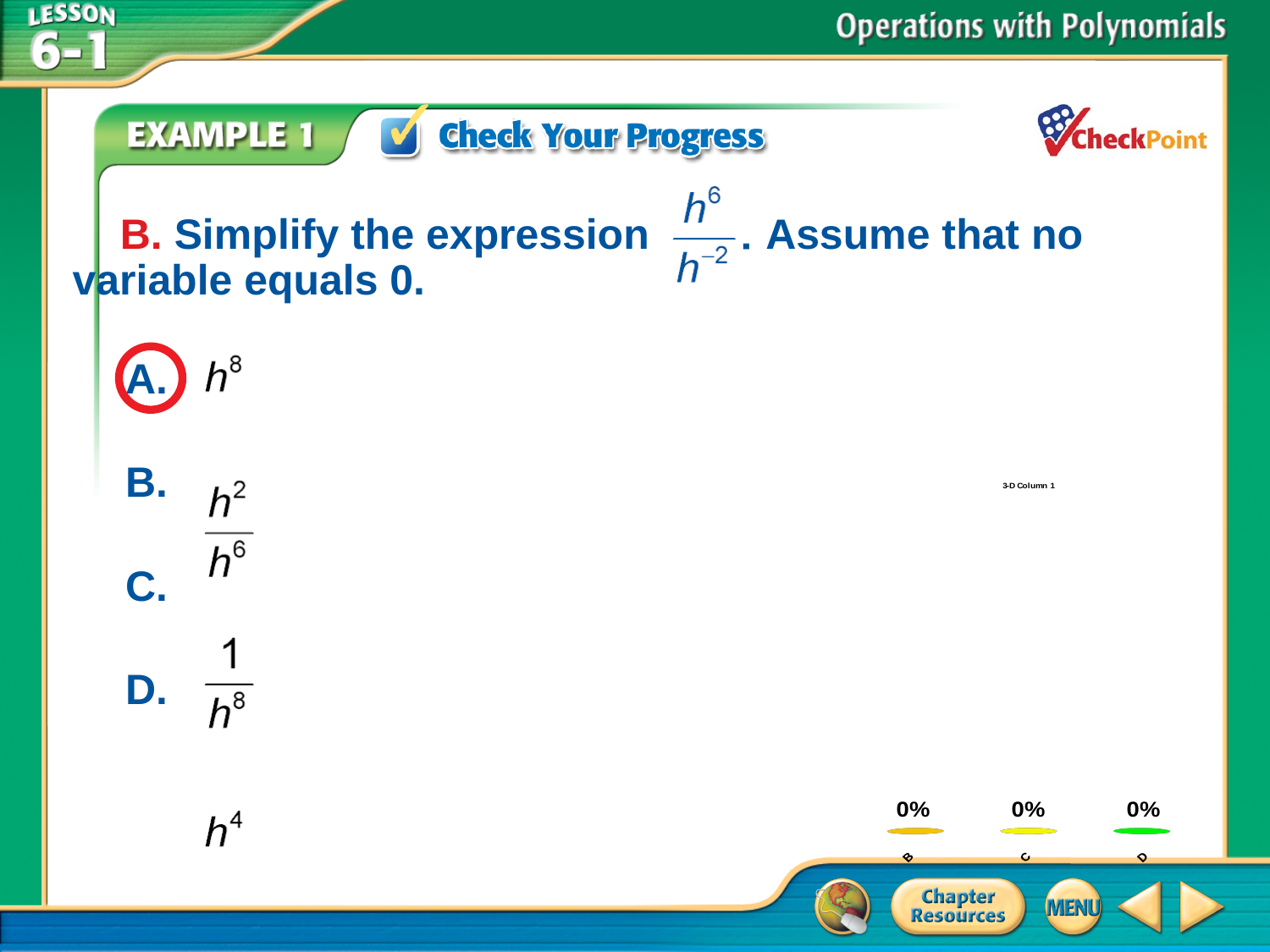
In the chart at the bottom right, is the value for C greater or less than 50%? less What kind of chart is shown at the bottom right of the slide? bar chart In the chart at the bottom right, what value is labelled for category C? 0% In the chart at the bottom right, what value is labelled for category D? 0% In the chart at the bottom right, what value is labelled for category B? 0% In the chart at the bottom right, what is the difference between the values for B and D? 0%